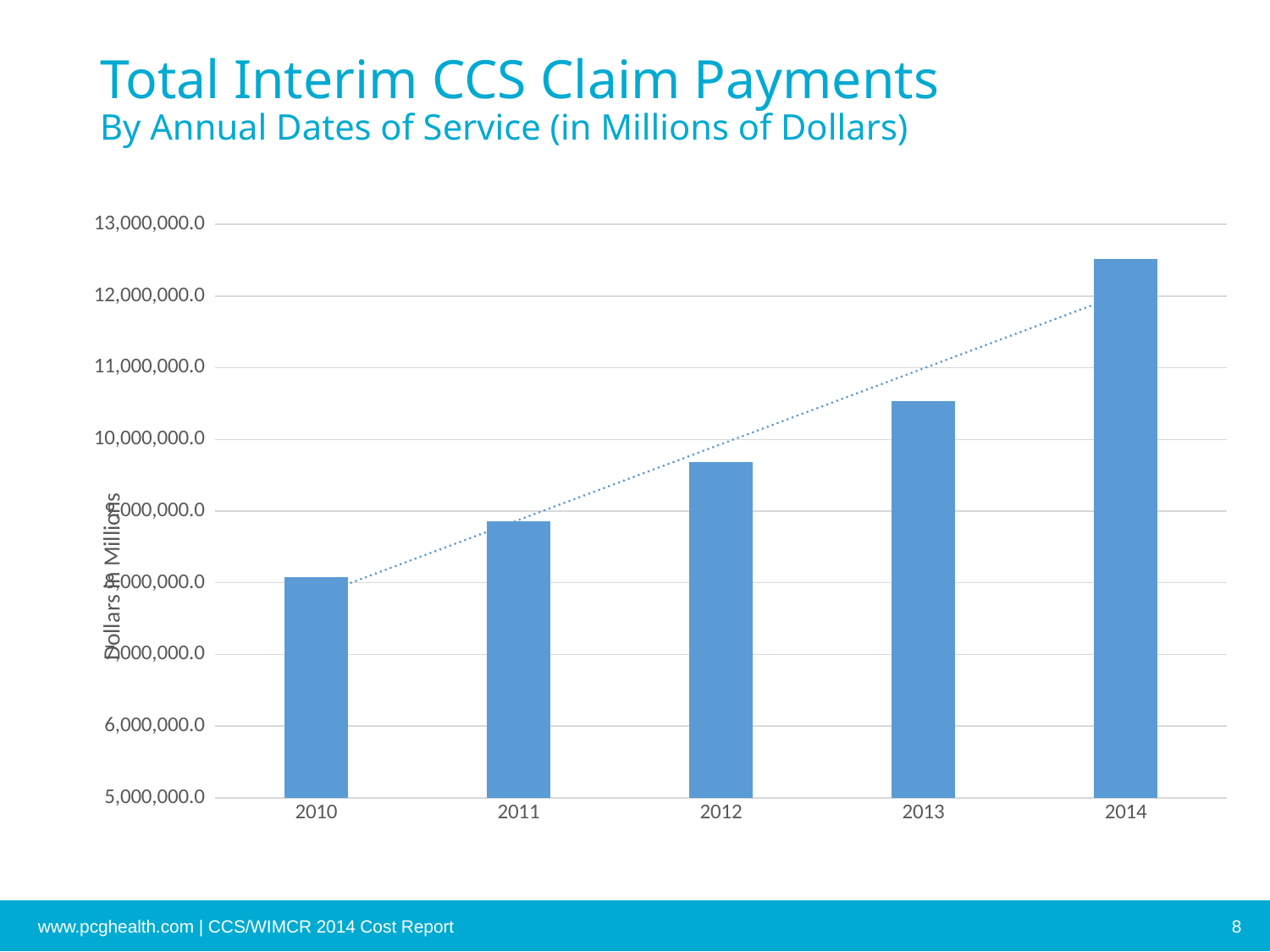
What is the title of the chart on the slide? Total Interim CCS Claim Payments Which year has the highest total interim CCS claim payments? 2014 What is the label on the y axis of the chart? Dollars in Millions Which year has the larger value, 2011 or 2013? 2013 Is the value for 2013 greater or less than 10,000,000.0? greater Is the value for 2012 greater or less than 9,000,000.0? greater Is the value for 2011 greater or less than 9,000,000.0? less How many years are shown on the x axis of the chart? 5 What kind of chart is shown on the slide? Bar chart Which year has the lowest total interim CCS claim payments? 2010 Do the claim payments rise or fall from 2010 to 2014? Rise